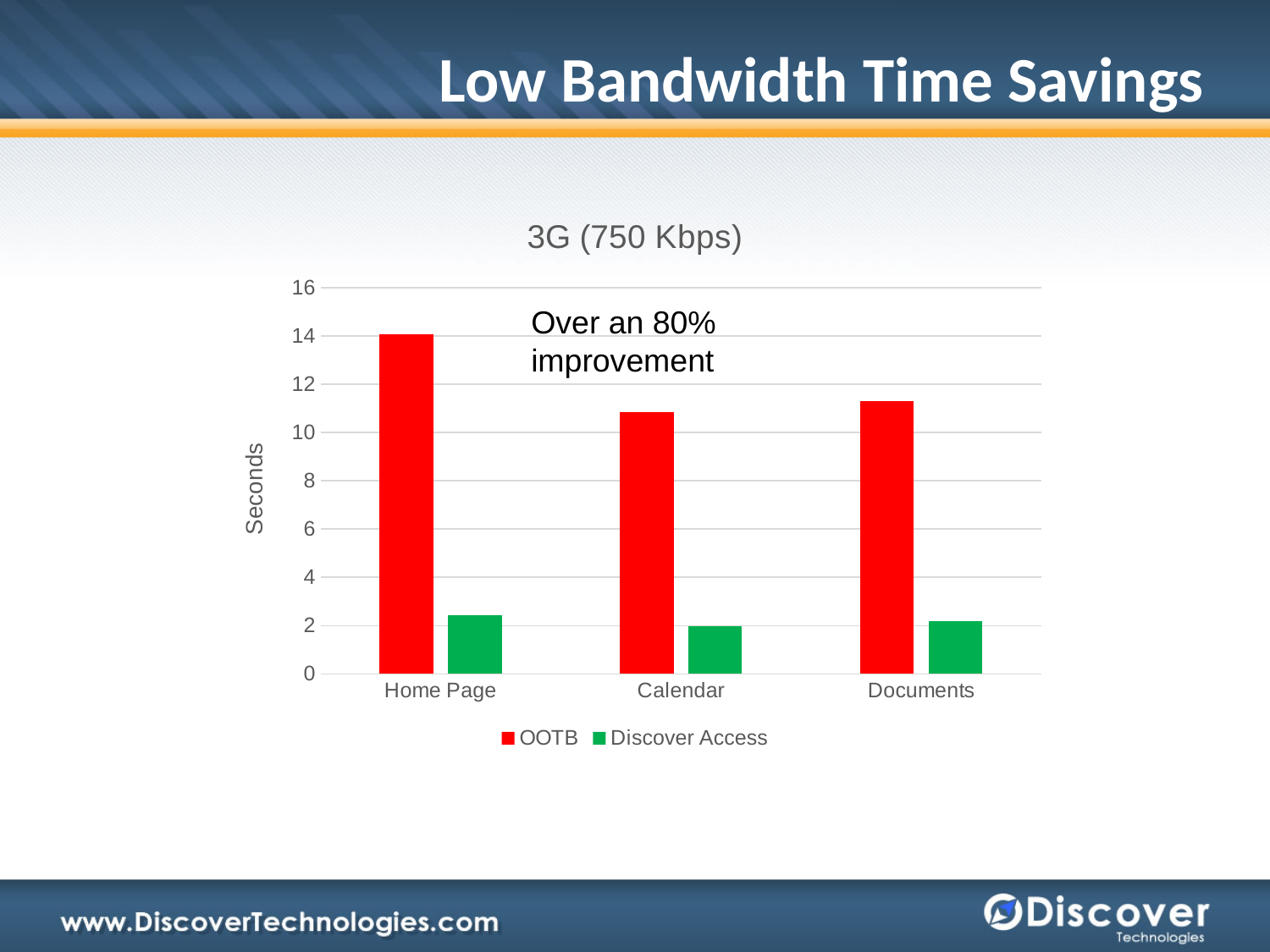
What is the title of the chart? 3G (750 Kbps) What kind of chart is shown on the slide? bar chart How many categories are shown on the x axis of the chart? 3 What is the label on the chart's y axis? Seconds Is the Discover Access value for Home Page greater or less than 4? less How many series does the chart's legend list? 2 Is the OOTB value for Documents greater or less than 10? greater Is the OOTB value for Calendar greater or less than 12? less Which category has the highest OOTB value? Home Page Which is larger, the OOTB value for Home Page or the OOTB value for Calendar? Home Page For Documents, which series has the larger value, OOTB or Discover Access? OOTB